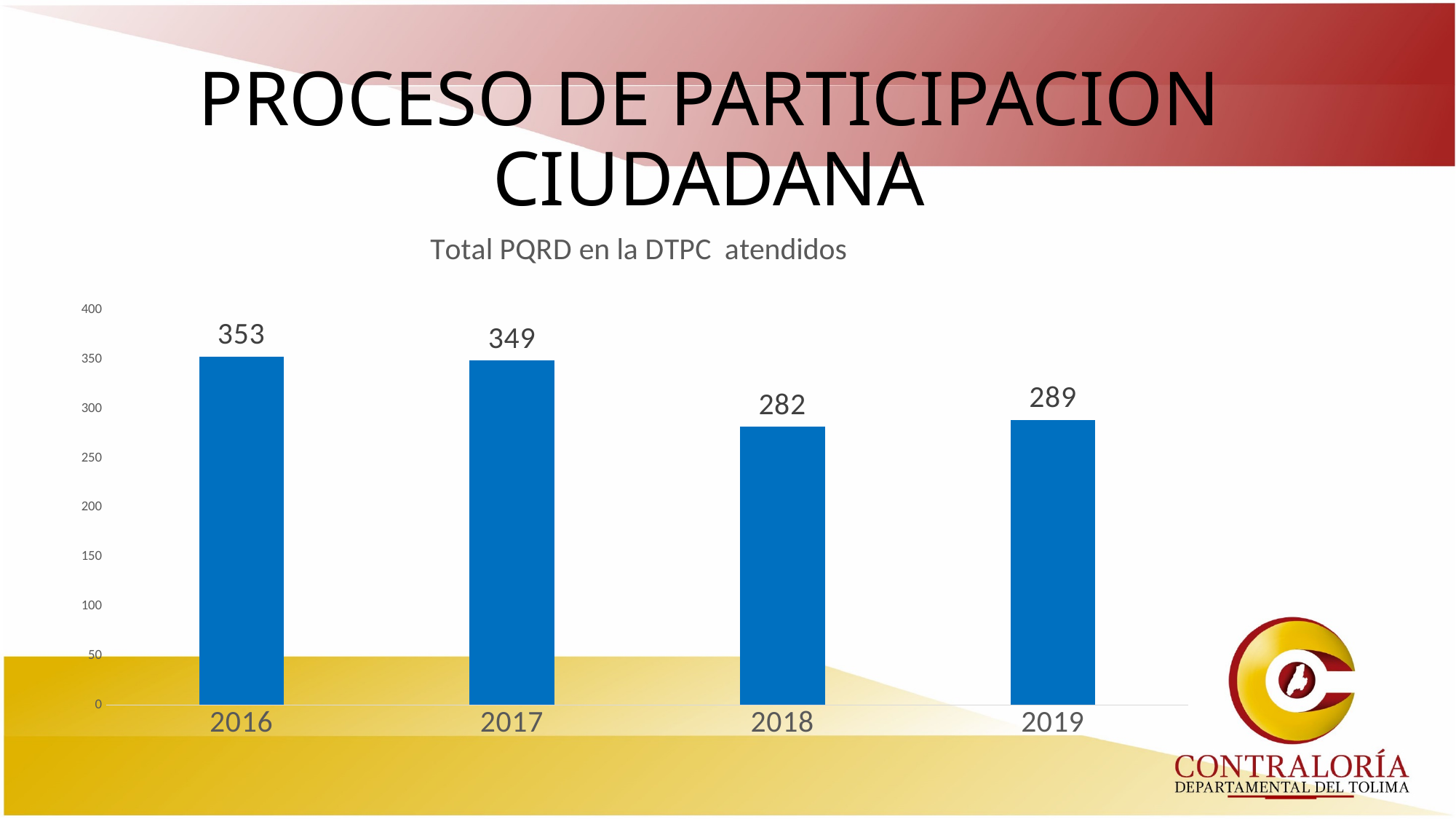
How many years are shown on the x axis? 4 What is the difference between the values for 2019 and 2018? 7 What is the value for 2018? 282 What is the difference between the values for 2016 and 2018? 71 What is the value for 2016? 353 Which is larger, the value for 2017 or the value for 2019? 2017 What is the title of the chart? Total PQRD en la DTPC atendidos Which year has the lowest value? 2018 What kind of chart is shown on the slide? bar chart Which year has the highest value? 2016 What is the value for 2019? 289 Is the value for 2018 greater or less than 300? less